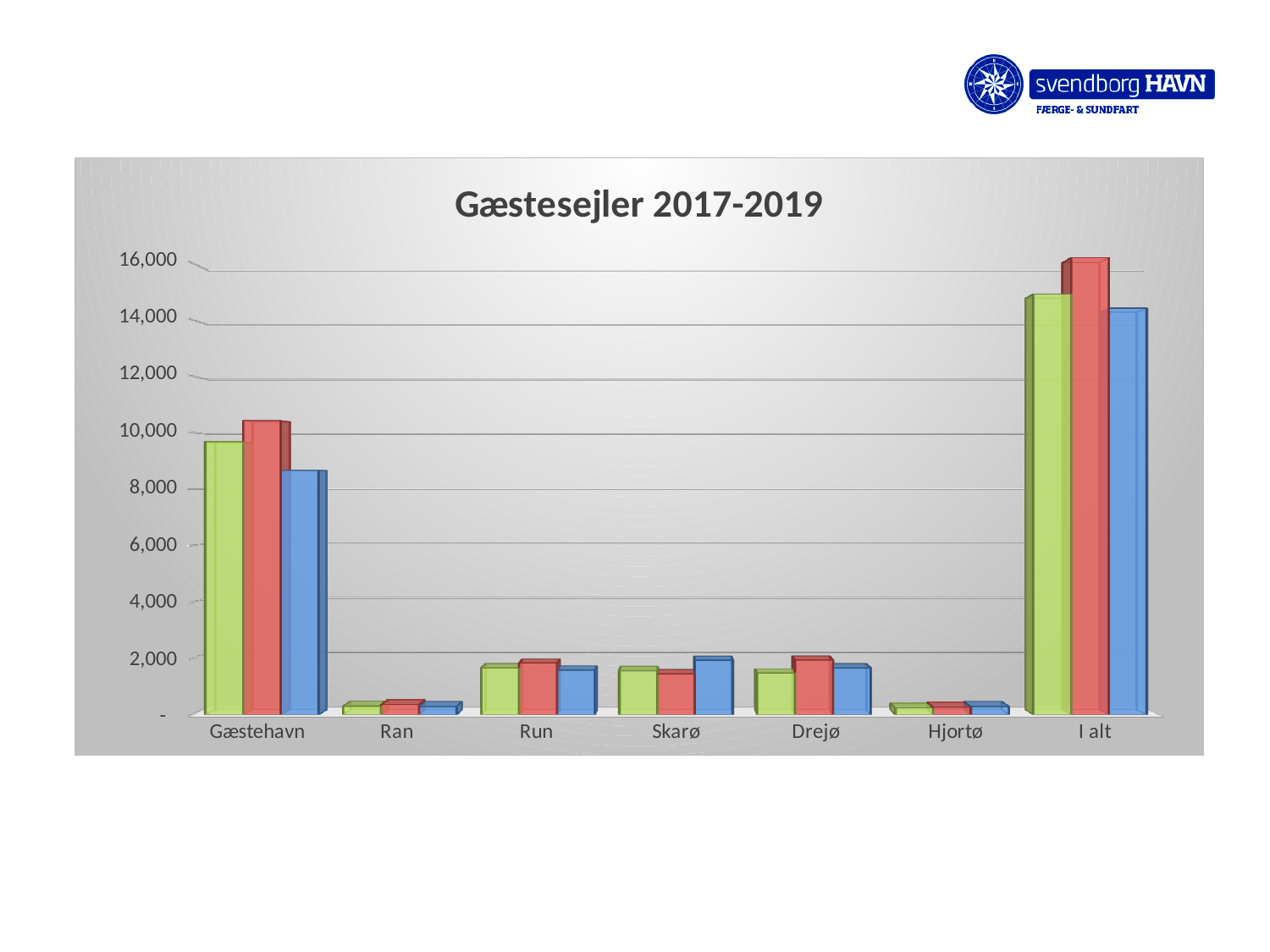
For I alt, which bar is taller, the green bar or the red bar? the red bar For Skarø, which bar is taller, the red bar or the blue bar? the blue bar Is the value of the red bar for Ran greater or less than 2,000? less Is the value of the green bar for Hjortø greater or less than 2,000? less For Gæstehavn, which bar is taller, the red bar or the blue bar? the red bar Is the value of the green bar for I alt greater or less than 14,000? greater How many bars are plotted for each category in the chart? 3 What is the title of the chart? Gæstesejler 2017-2019 How many categories are shown on the x axis of the chart? 7 What kind of chart is shown on the slide? bar chart Which category has the tallest bars in the chart? I alt